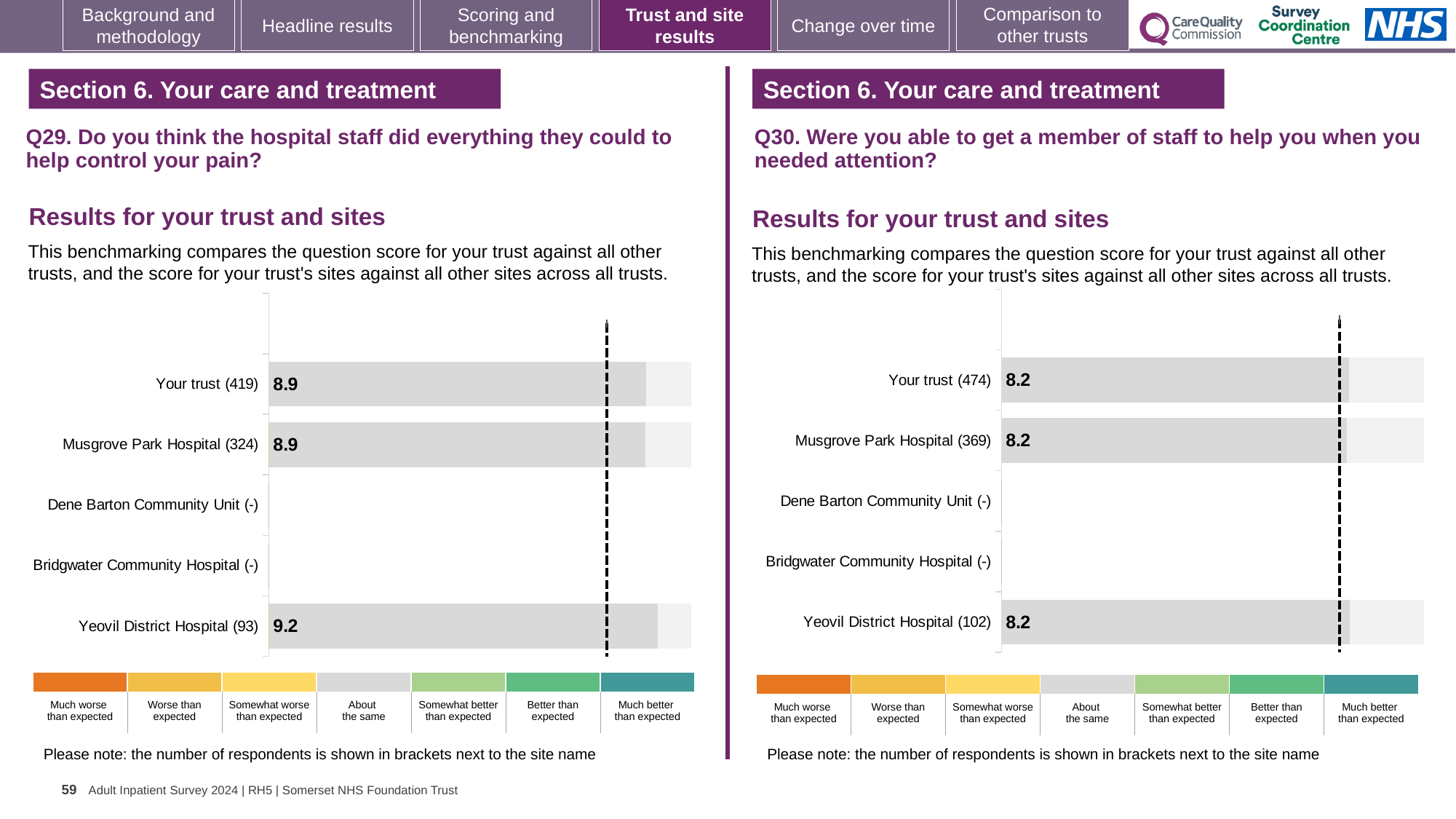
In the Q29 chart on the left, what is the difference between the scores for Yeovil District Hospital and Musgrove Park Hospital? 0.3 In the Q30 chart on the right, what is the difference between the scores for Your trust and Musgrove Park Hospital? 0 How many site categories are listed on the y axis of the Q30 chart on the right? 5 In the Q29 chart on the left, what is the score for Your trust? 8.9 In the Q30 chart on the right, what is the score for Your trust? 8.2 In the Q29 chart on the left, which has the larger score, Yeovil District Hospital or Your trust? Yeovil District Hospital In the Q29 chart on the left, what is the score for Musgrove Park Hospital? 8.9 In the Q29 chart on the left, which site has the highest score? Yeovil District Hospital In the Q29 chart on the left, what is the score for Yeovil District Hospital? 9.2 What kind of chart is the Q29 chart on the left? Bar chart In the Q29 chart on the left, how many respondents are shown in brackets for Your trust? 419 In the Q30 chart on the right, what is the score for Yeovil District Hospital? 8.2